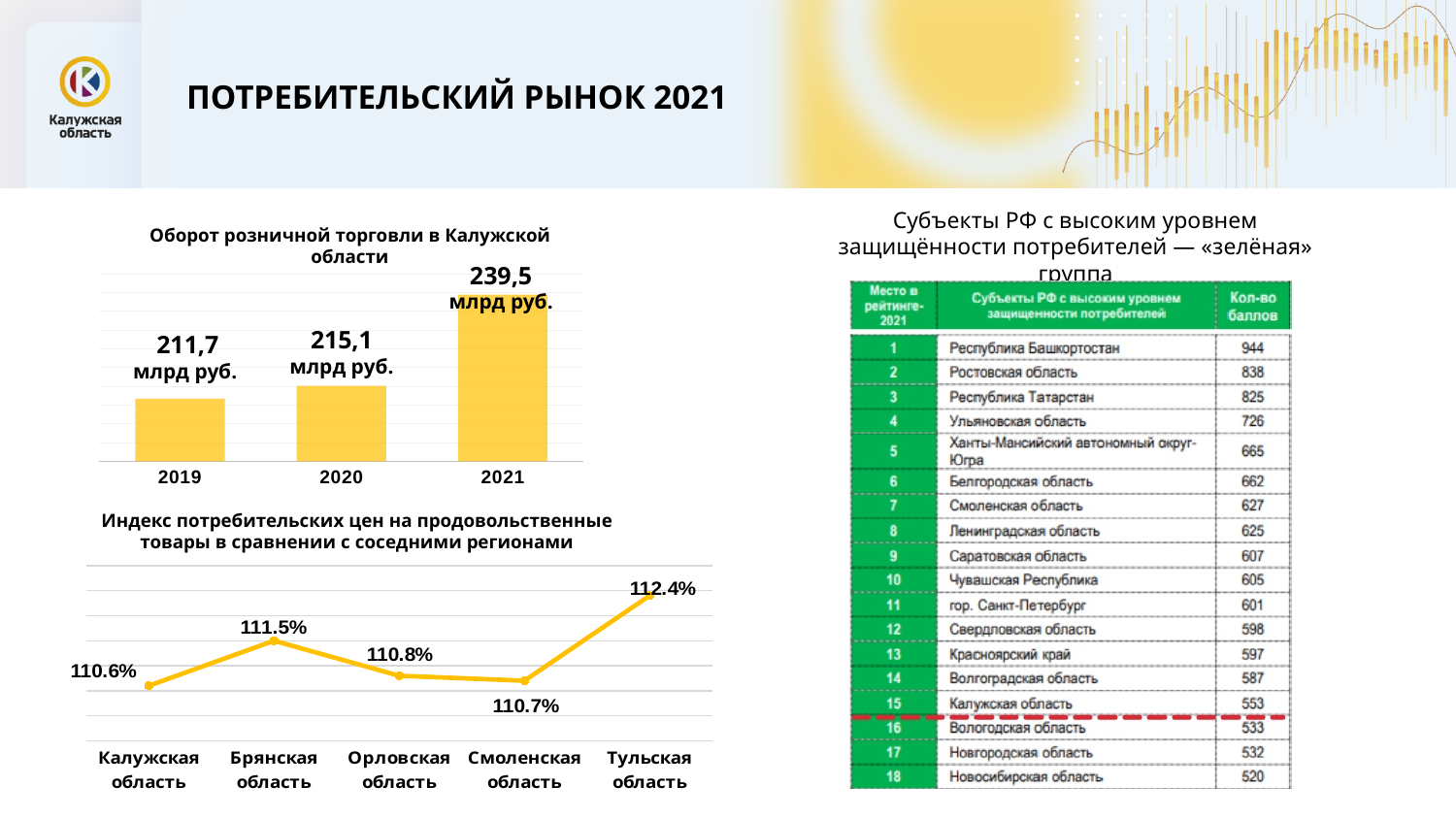
In the chart 'Оборот розничной торговли в Калужской области', which year has the lowest value? 2019 How many years are shown in the chart 'Оборот розничной торговли в Калужской области'? 3 What kind of chart is 'Оборот розничной торговли в Калужской области'? bar chart What kind of chart is 'Индекс потребительских цен на продовольственные товары в сравнении с соседними регионами'? line chart In the chart 'Индекс потребительских цен на продовольственные товары в сравнении с соседними регионами', what is the value for Брянская область? 111.5% In the chart 'Индекс потребительских цен на продовольственные товары в сравнении с соседними регионами', which region has the lowest value? Калужская область In the chart 'Оборот розничной торговли в Калужской области', do the values rise or fall from 2019 to 2021? rise In the chart 'Индекс потребительских цен на продовольственные товары в сравнении с соседними регионами', which is larger: the value for Орловская область or Смоленская область? Орловская область In the chart 'Индекс потребительских цен на продовольственные товары в сравнении с соседними регионами', which region has the highest value? Тульская область In the chart 'Оборот розничной торговли в Калужской области', what is the value for 2019? 211,7 млрд руб. In the chart 'Оборот розничной торговли в Калужской области', what is the value for 2021? 239,5 млрд руб. In the chart 'Оборот розничной торговли в Калужской области', what is the difference between the 2021 and 2020 values? 24,4 млрд руб.